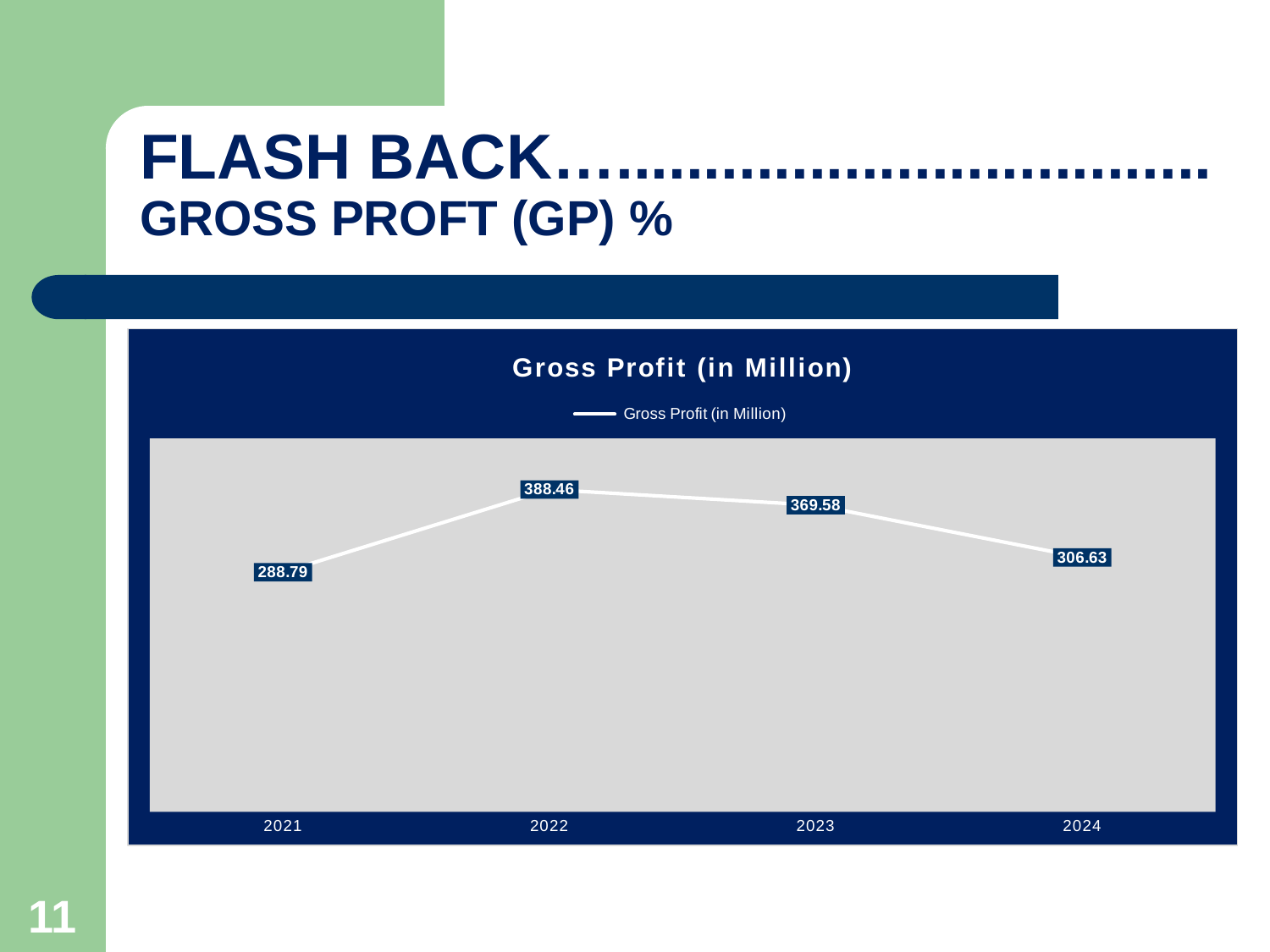
What is the Gross Profit (in Million) for 2022? 388.46 What is the Gross Profit (in Million) for 2023? 369.58 What kind of chart is shown on the slide? Line chart Which year has the lowest Gross Profit? 2021 What is the Gross Profit (in Million) for 2024? 306.63 What is the difference in Gross Profit between 2023 and 2024? 62.95 What is the Gross Profit (in Million) for 2021? 288.79 What is the difference in Gross Profit between 2022 and 2021? 99.67 What is the title of the chart? Gross Profit (in Million) Which year has the highest Gross Profit? 2022 How many years are plotted on the chart? 4 Which year has a larger Gross Profit, 2023 or 2024? 2023